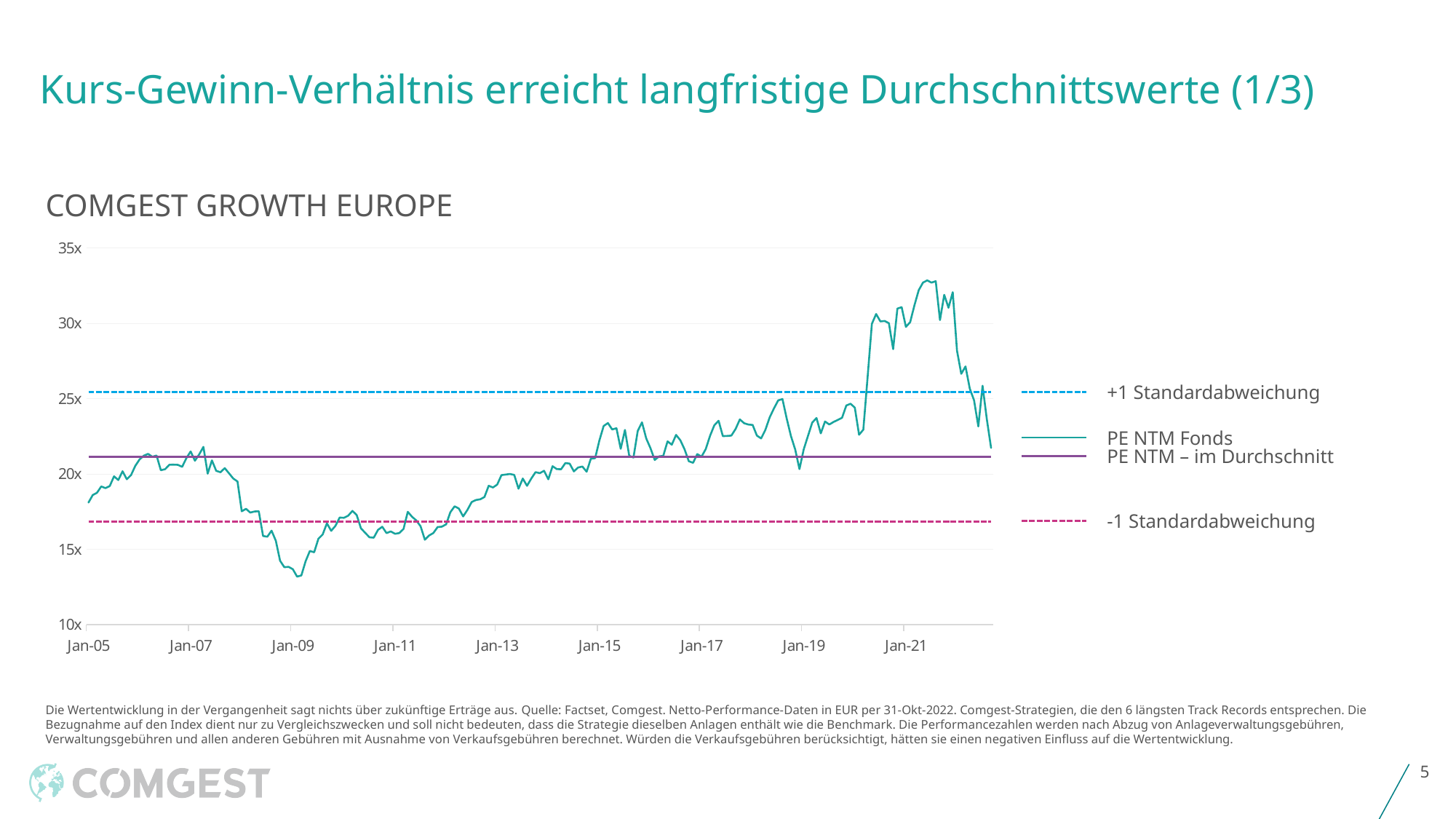
Which legend entry is drawn as a dashed blue line? +1 Standardabweichung Is the PE NTM Fonds value at Jan-05 greater or less than 20x? less What is the title of the chart? COMGEST GROWTH EUROPE Is the highest point of the PE NTM Fonds line greater or less than 30x? greater Is the PE NTM Fonds value at Jan-21 higher or lower than at Jan-09? higher Between Jan-09 and Jan-15, does the PE NTM Fonds line generally rise or fall? rise Is the PE NTM – im Durchschnitt line greater or less than 20x? greater What kind of chart is shown on the slide? line chart How many labelled tick marks are on the x axis? 9 How many series does the legend list? 4